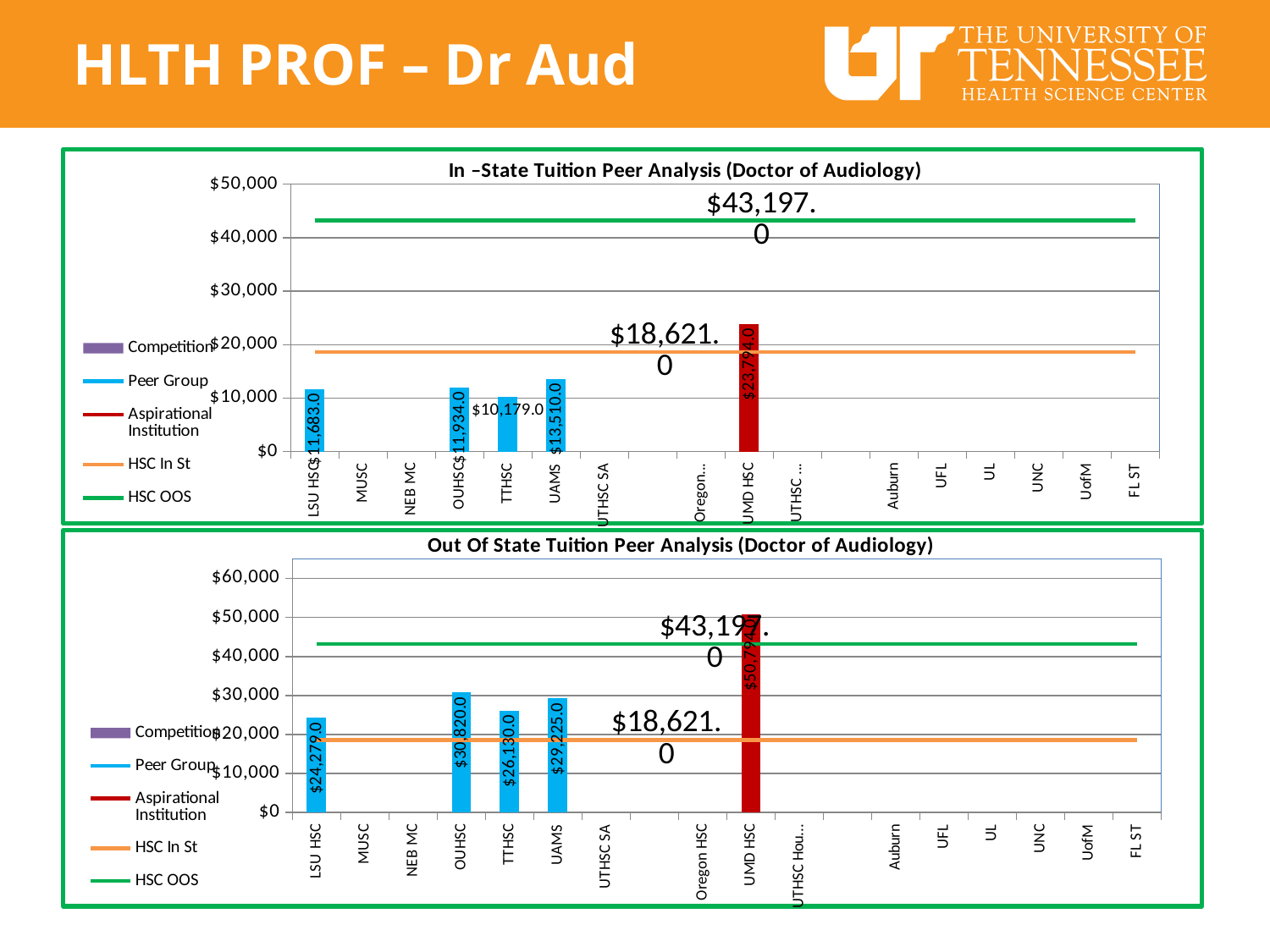
In the In-State Tuition Peer Analysis chart, what is the value for UAMS? $13,510.0 In the In-State Tuition Peer Analysis chart, what is the difference between the UMD HSC value and the UAMS value? $10,284.0 In the Out Of State Tuition Peer Analysis chart, what value is labelled on the HSC OOS line? $43,197.0 What kind of chart is the Out Of State Tuition Peer Analysis chart? bar chart In the In-State Tuition Peer Analysis chart, which institution has the lowest bar? TTHSC In the Out Of State Tuition Peer Analysis chart, is the value for TTHSC greater or less than $20,000? greater In the In-State Tuition Peer Analysis chart, which institution has the highest bar? UMD HSC In the Out Of State Tuition Peer Analysis chart, which institution has the lowest bar? LSU HSC How many series does the legend of the In-State Tuition Peer Analysis chart list? 5 In the Out Of State Tuition Peer Analysis chart, what is the value for OUHSC? $30,820.0 In the Out Of State Tuition Peer Analysis chart, what is the difference between the UMD HSC value and the LSU HSC value? $26,515.0 In the In-State Tuition Peer Analysis chart, which is larger, the value for LSU HSC or the value for OUHSC? OUHSC